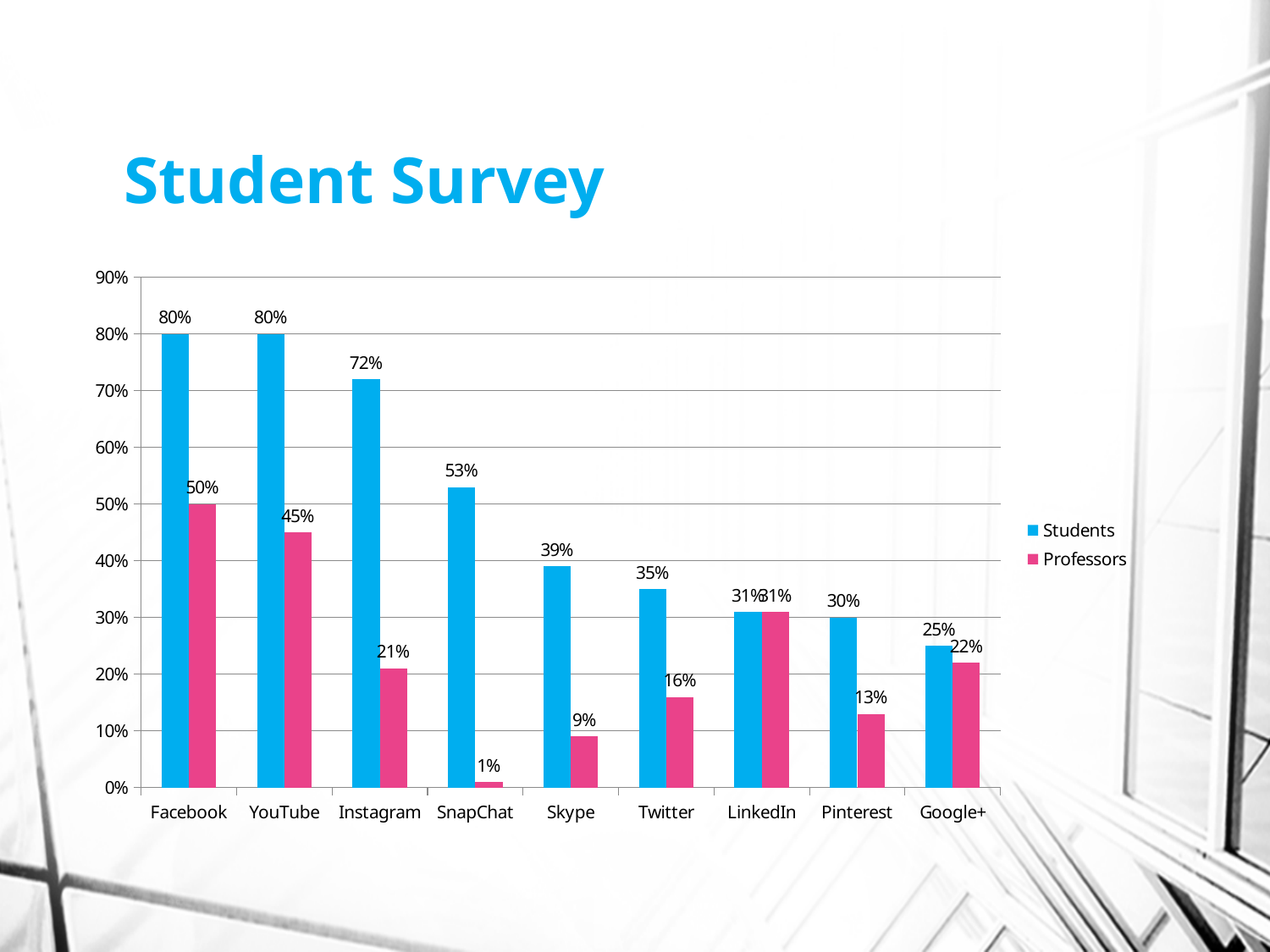
What kind of chart is shown on the slide? Bar chart Do the Students values rise or fall from Facebook to Google+ along the x axis? Fall What percentage of professors use SnapChat? 1% Which platform has the lowest value for Professors? SnapChat What is the title of the slide? Student Survey Which is larger for Google+, the Students value or the Professors value? Students What is the value for Professors on Twitter? 16% Which platform has the highest value for Professors? Facebook What percentage of students use Instagram? 72% What is the difference between the Students and Professors values for Instagram? 51% How many series does the legend list? 2 How many platforms are shown on the x axis? 9